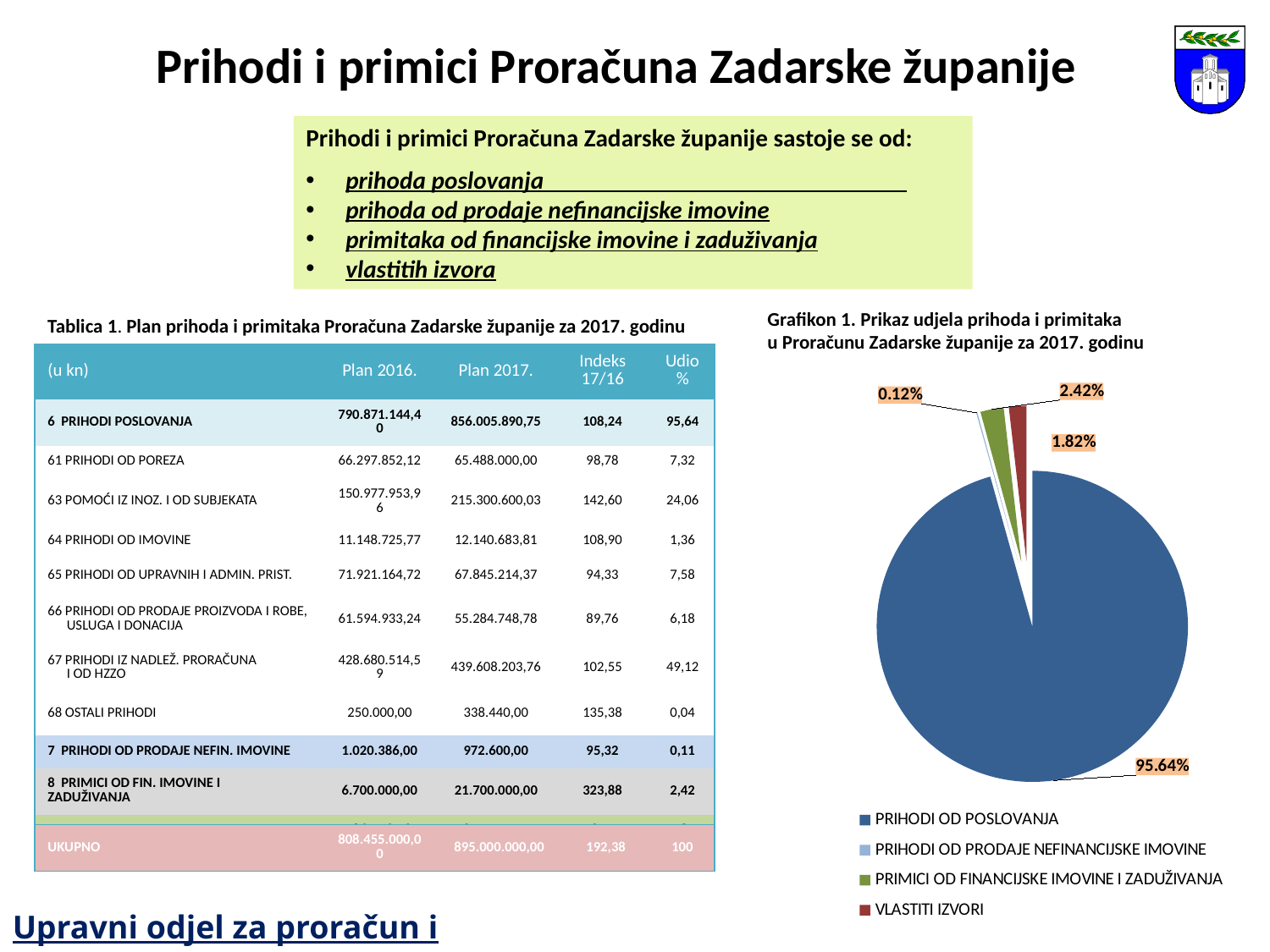
In the pie chart (Grafikon 1), which is larger: the slice for PRIHODI OD POSLOVANJA or the slice for VLASTITI IZVORI? PRIHODI OD POSLOVANJA What kind of chart is Grafikon 1 on the slide? pie chart How many entries does the legend of the pie chart (Grafikon 1) list? 4 How many slices does the pie chart (Grafikon 1) have? 4 In the pie chart (Grafikon 1), what share is shown for PRIHODI OD POSLOVANJA? 95.64% Is the share for PRIHODI OD POSLOVANJA in the pie chart (Grafikon 1) greater or less than 90%? greater In the pie chart (Grafikon 1), which legend entry is shown in dark blue? PRIHODI OD POSLOVANJA In the pie chart (Grafikon 1), what is the smallest percentage label shown? 0.12% What is the title of the pie chart on the slide? Grafikon 1. Prikaz udjela prihoda i primitaka u Proračunu Zadarske županije za 2017. godinu In the pie chart (Grafikon 1), which category has the largest slice? PRIHODI OD POSLOVANJA In the pie chart (Grafikon 1), what is the difference between the largest label (95.64%) and the smallest label (0.12%)? 95.52%